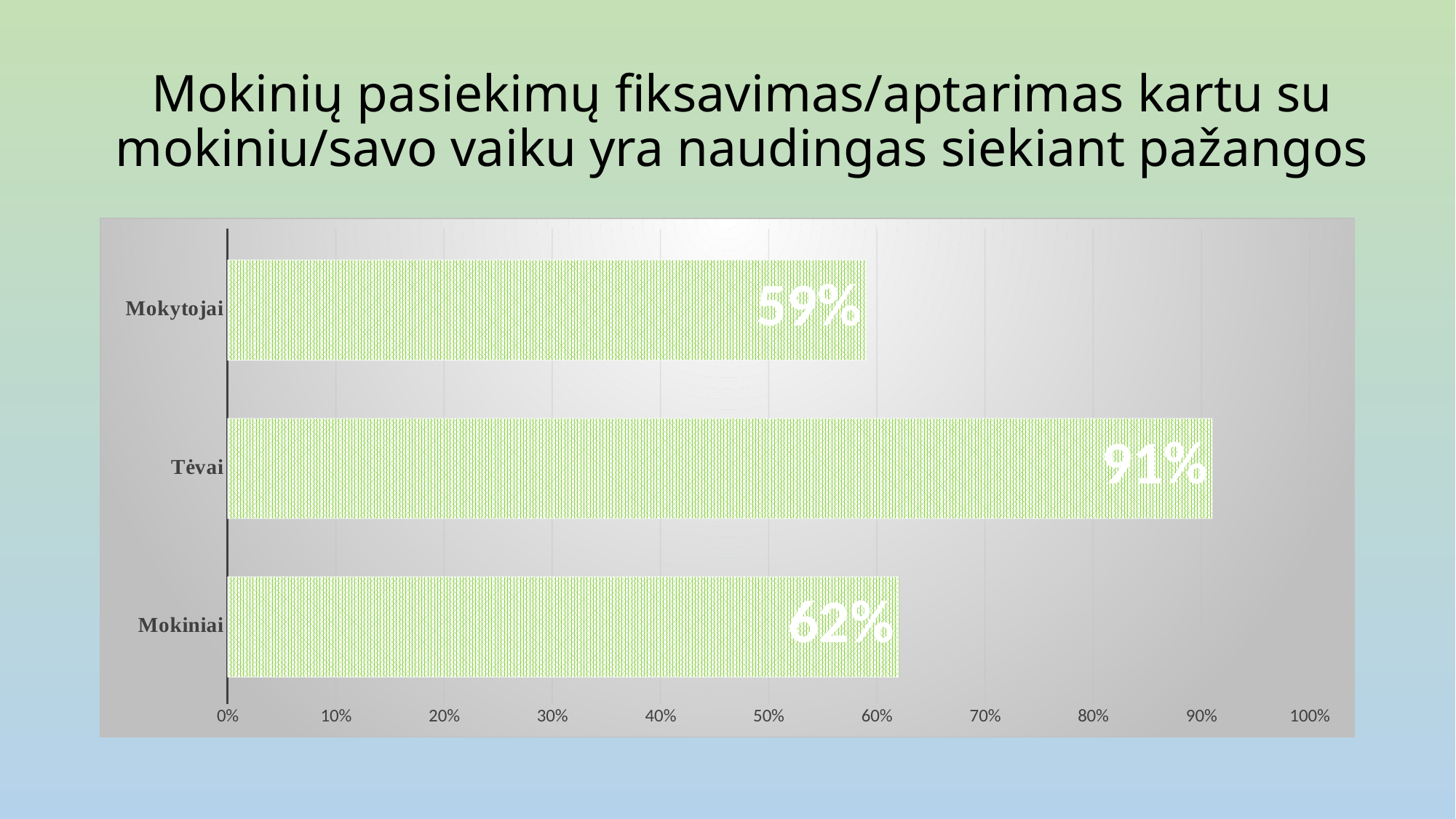
Which is larger, the value for Tėvai or the value for Mokiniai? Tėvai What is the difference between the values for Mokiniai and Mokytojai? 3% What is the difference between the values for Tėvai and Mokytojai? 32% What is the maximum value shown on the horizontal axis? 100% How many categories are shown in the chart? 3 What is the value for Mokiniai? 62% Is the value for Tėvai greater or less than 80%? greater Which category has the lowest value? Mokytojai What kind of chart is shown on the slide? bar chart Which category has the highest value? Tėvai What is the value for Mokytojai? 59% What is the value for Tėvai? 91%